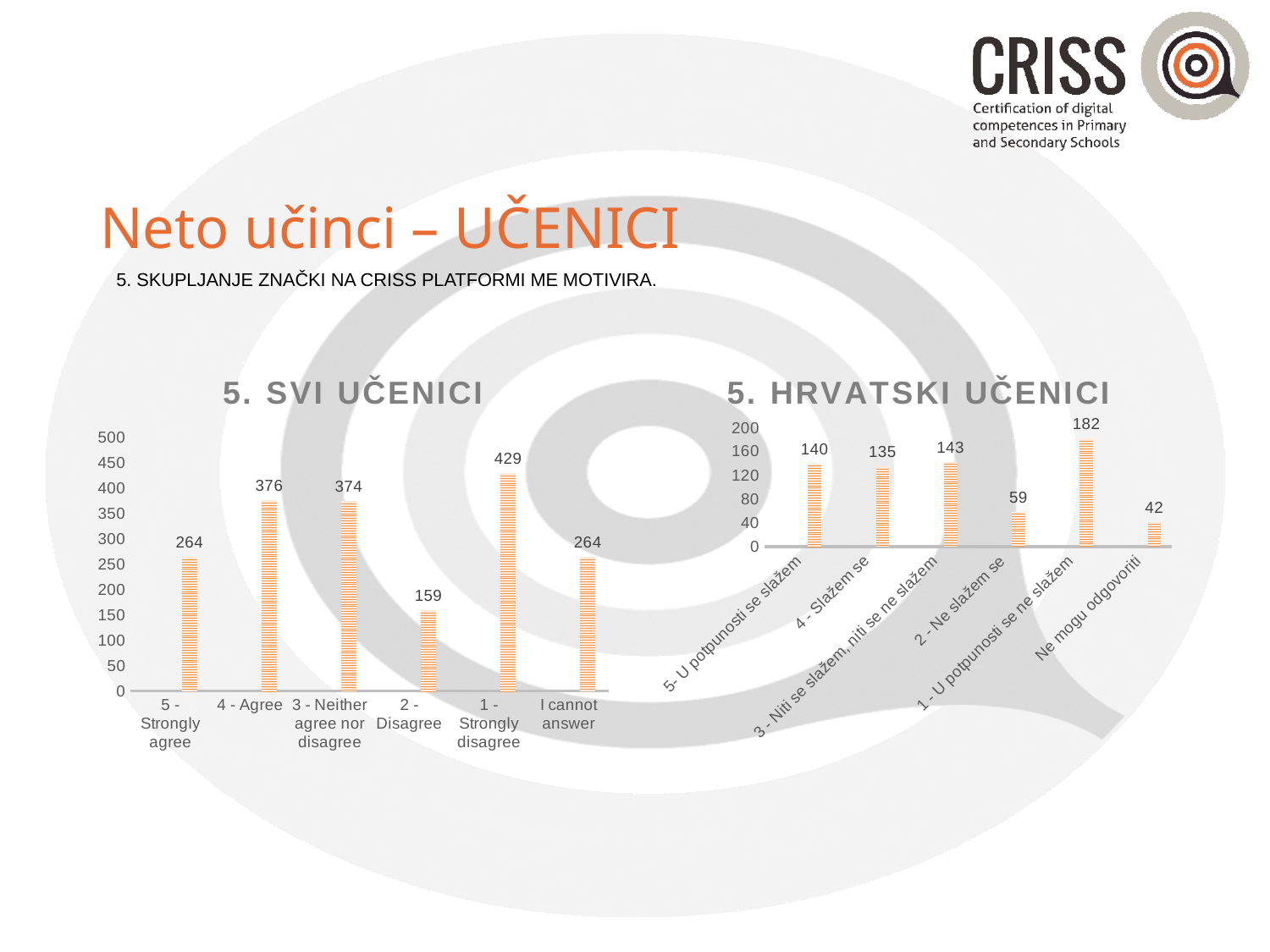
In the chart titled "5. HRVATSKI UČENICI", which is larger: the value for "5 - U potpunosti se slažem" or the value for "2 - Ne slažem se"? 5 - U potpunosti se slažem In the chart titled "5. SVI UČENICI", what is the difference between the values for "1 - Strongly disagree" and "2 - Disagree"? 270 In the chart titled "5. HRVATSKI UČENICI", what is the value for "2 - Ne slažem se"? 59 In the chart titled "5. SVI UČENICI", which category has the lowest value? 2 - Disagree In the chart titled "5. SVI UČENICI", what is the value for "1 - Strongly disagree"? 429 In the chart titled "5. HRVATSKI UČENICI", which category has the highest value? 1 - U potpunosti se ne slažem In the chart titled "5. SVI UČENICI", what is the value for "4 - Agree"? 376 In the chart titled "5. SVI UČENICI", how many categories are shown on the x axis? 6 What kind of chart is the chart titled "5. HRVATSKI UČENICI"? Bar chart In the chart titled "5. SVI UČENICI", is the value for "5 - Strongly agree" greater or less than 300? less In the chart titled "5. HRVATSKI UČENICI", which category has the lowest value? Ne mogu odgovoriti In the chart titled "5. HRVATSKI UČENICI", what is the difference between the values for "1 - U potpunosti se ne slažem" and "Ne mogu odgovoriti"? 140